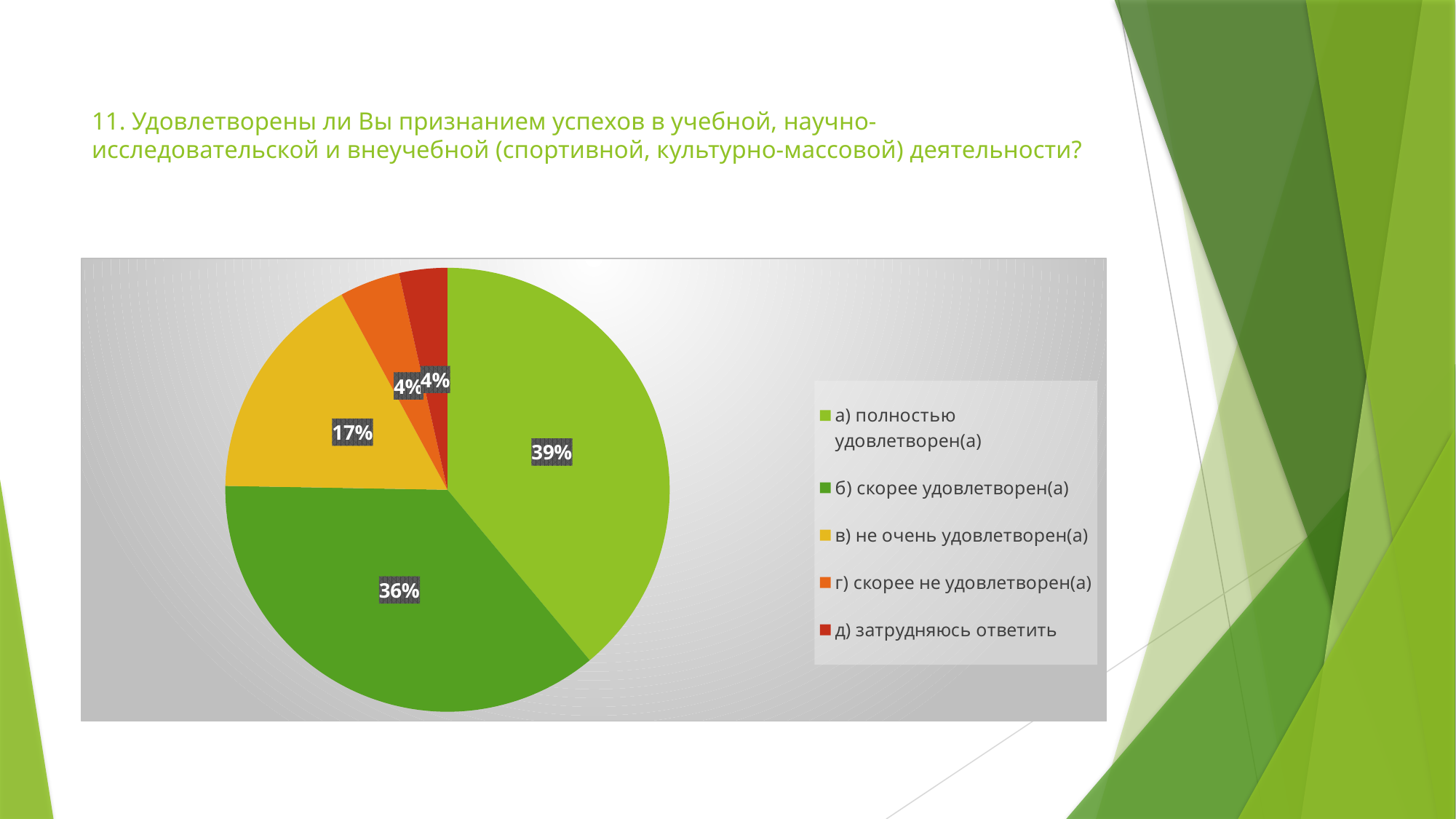
What colour is the slice for "д) затрудняюсь ответить"? red What is the difference between the shares for "а) полностью удовлетворен(а)" and "б) скорее удовлетворен(а)"? 3% Which is larger: the share for "в) не очень удовлетворен(а)" or the share for "г) скорее не удовлетворен(а)"? в) не очень удовлетворен(а) What share of the pie is labelled "а) полностью удовлетворен(а)"? 39% What is the combined share of "а) полностью удовлетворен(а)" and "б) скорее удовлетворен(а)"? 75% What share of the pie is labelled "г) скорее не удовлетворен(а)"? 4% What share of the pie is labelled "д) затрудняюсь ответить"? 4% What share of the pie is labelled "б) скорее удовлетворен(а)"? 36% How many slices does the pie chart have? 5 What kind of chart is shown on the slide? pie chart What share of the pie is labelled "в) не очень удовлетворен(а)"? 17% Which category has the largest slice of the pie? а) полностью удовлетворен(а)